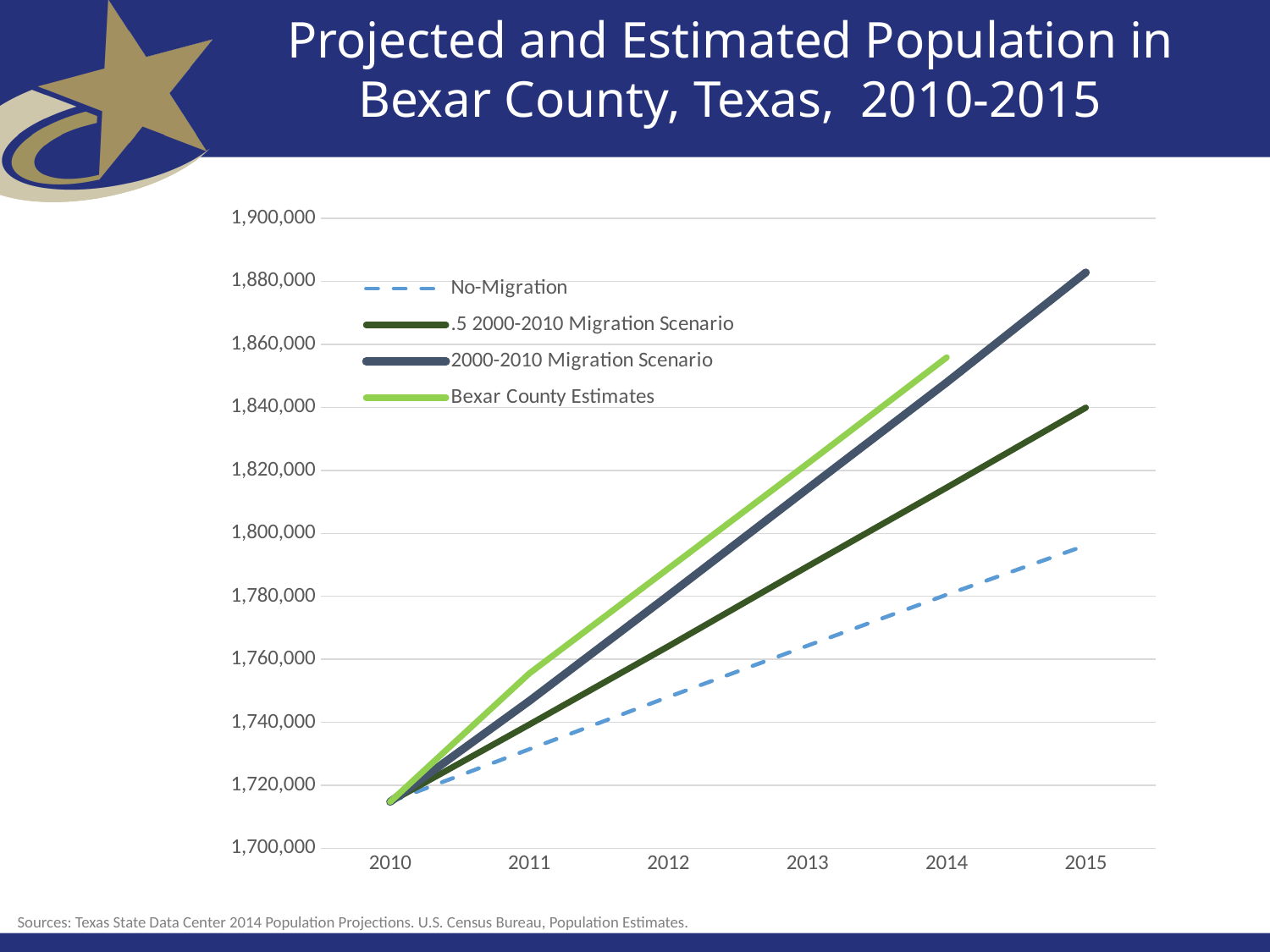
Is the Bexar County Estimates value for 2014 greater or less than 1,840,000? greater Which series has the highest value in 2015? 2000-2010 Migration Scenario What kind of chart is shown on the slide? line chart Do the population values rise or fall from 2010 to 2015 for the 2000-2010 Migration Scenario? rise Is the 2000-2010 Migration Scenario value for 2015 greater or less than 1,860,000? greater Which series has the lowest value in 2015? No-Migration In 2013, which is larger: the Bexar County Estimates value or the No-Migration value? Bexar County Estimates Is the No-Migration value for 2015 greater or less than 1,800,000? less How many years are shown on the x axis? 6 What is the title of the chart on the slide? Projected and Estimated Population in Bexar County, Texas, 2010-2015 Which series is drawn with a dashed line? No-Migration How many series does the legend list? 4